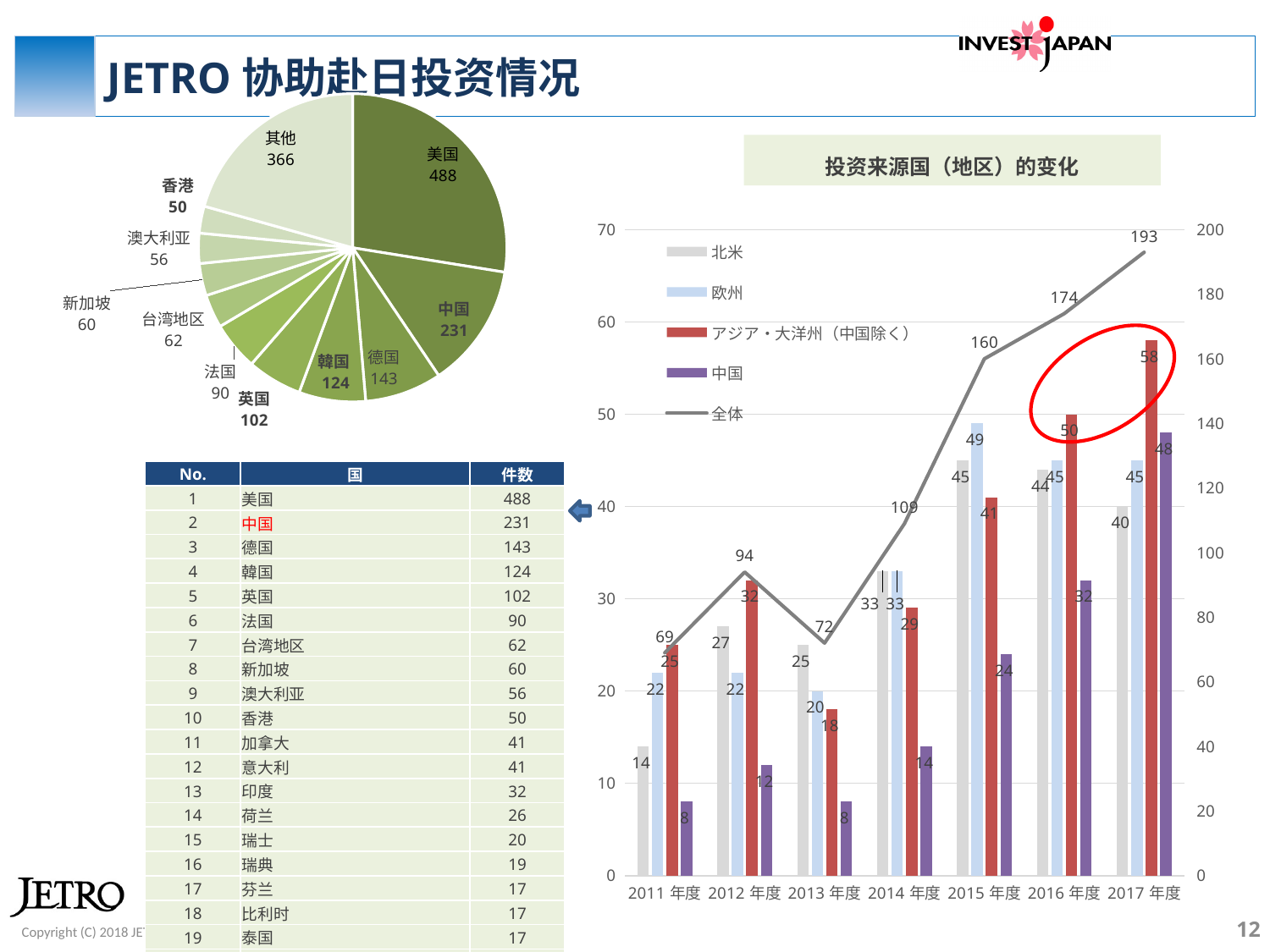
In the chart titled 投资来源国（地区）的变化, which series is drawn as a line rather than bars? 全体 In the chart titled 投资来源国（地区）的变化, how many series does the legend list? 5 In the pie chart on the left, what is the value for 美国? 488 In the pie chart on the left, which labelled slice has the largest value? 美国 In the chart titled 投资来源国（地区）的变化, what is the value of the 全体 line for 2017 年度? 193 In the chart titled 投资来源国（地区）的变化, what is the value for 中国 in 2016 年度? 32 In the pie chart on the left, which is larger, the value for 韩国 or the value for 英国? 韩国 In the chart titled 投资来源国（地区）的变化, does the 全体 line rise or fall from 2014 年度 to 2017 年度? rise In the pie chart on the left, what is the difference between the values for 中国 and 德国? 88 In the chart titled 投资来源国（地区）的变化, in which year is the 全体 line lowest? 2011 年度 In the chart titled 投资来源国（地区）的变化, what is the difference between the アジア・大洋州（中国除く） values for 2017 年度 and 2016 年度? 8 In the chart titled 投资来源国（地区）的变化, how many years are shown on the x axis? 7